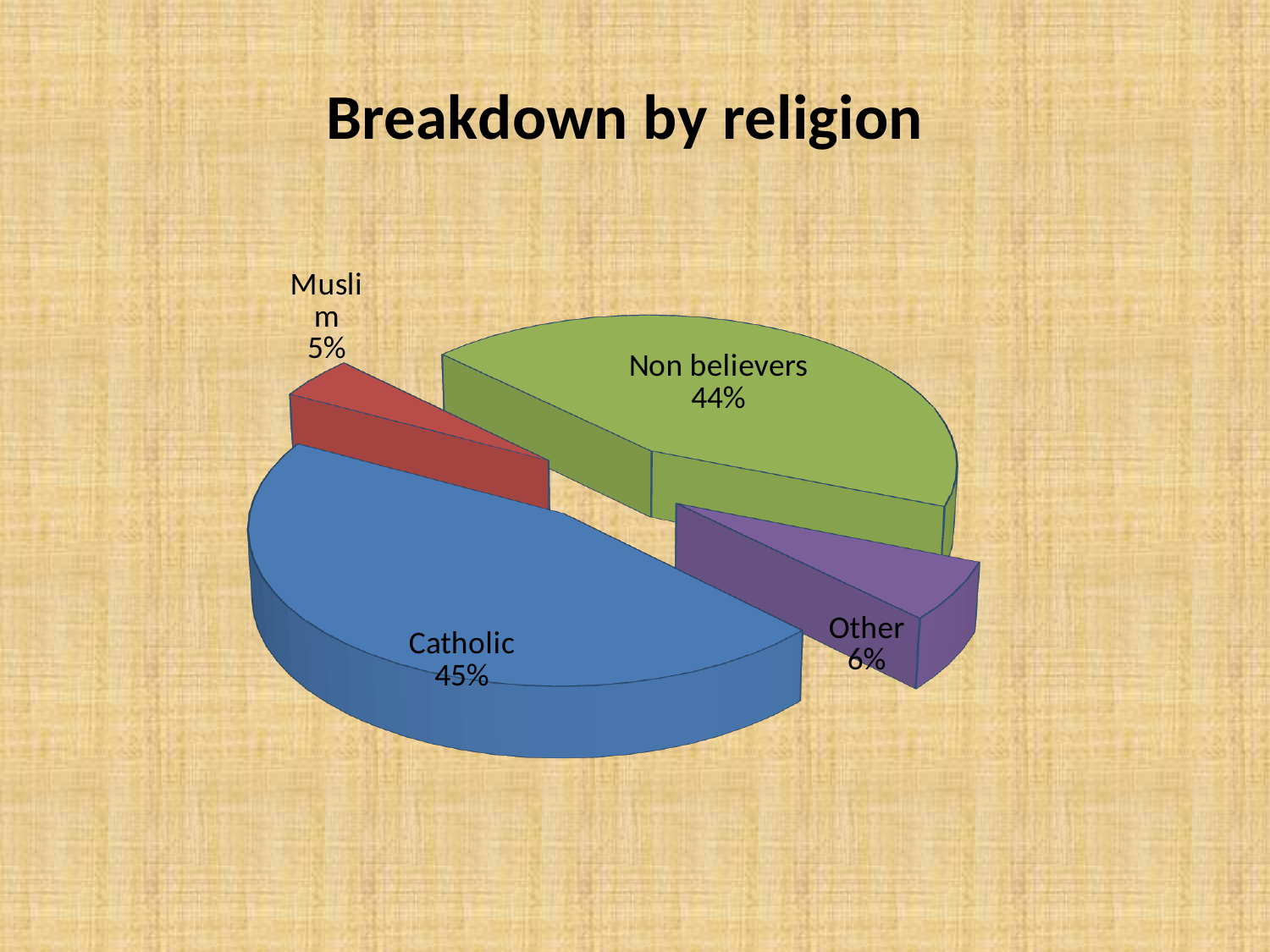
What is the value shown for Other? 6% How many categories are shown in the pie chart? 4 What kind of chart is shown on the slide? Pie chart Which category has the largest slice of the pie? Catholic What is the difference between the Other and Muslim shares? 1% What share of the pie does Catholic represent? 45% Which category has the smallest slice of the pie? Muslim What is the title of the chart? Breakdown by religion What is the value shown for Muslim? 5% What share of the pie does Non believers represent? 44% What colour is the Non believers slice? Green What is the difference between the Catholic and Non believers shares? 1%